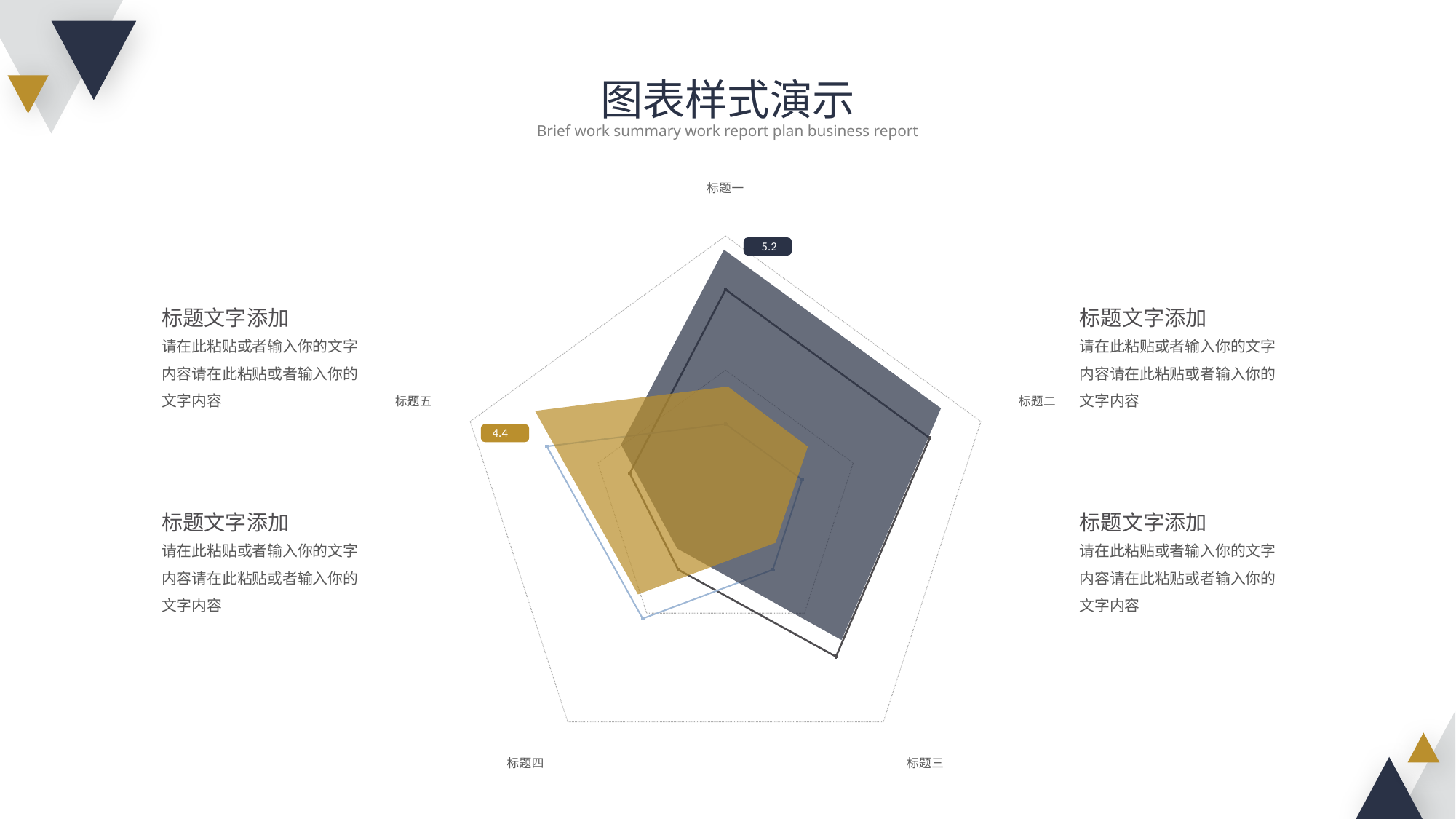
What value is labelled on the 标题五 axis of the radar chart? 4.4 Which is larger: the labelled value on the 标题一 axis or the labelled value on the 标题五 axis? 标题一 (5.2) What kind of chart is shown on the slide? Radar chart Which category label is at the bottom-right corner of the radar chart? 标题三 Which category label is at the bottom-left corner of the radar chart? 标题四 What is the title of the slide containing the radar chart? 图表样式演示 Which category label appears at the top of the radar chart? 标题一 What is the difference between the labelled value on the 标题一 axis (5.2) and the labelled value on the 标题五 axis (4.4)? 0.8 How many axes (categories) does the radar chart have? 5 What value is labelled on the 标题一 axis of the radar chart? 5.2